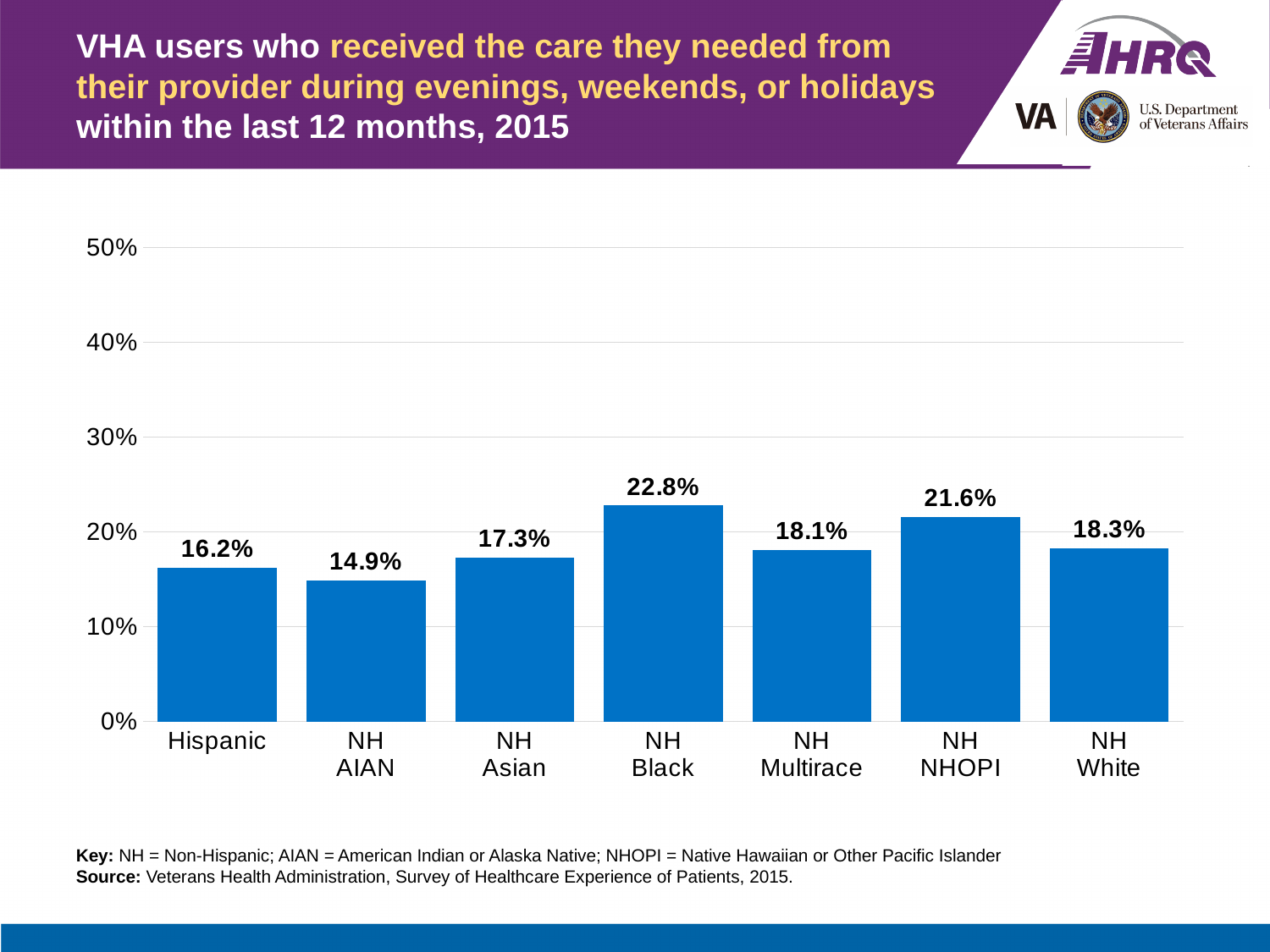
Which category has the highest value? NH Black What is the value for NH NHOPI? 21.6% What is the value for Hispanic? 16.2% What is the value for NH Black? 22.8% Which is larger, the value for NH Multirace or the value for Hispanic? NH Multirace What is the highest value labelled on the y axis? 50% How many categories are shown on the x axis? 7 Is the value for NH NHOPI greater or less than 20%? greater What is the difference between the values for NH Black and NH AIAN? 7.9% What kind of chart is shown on the slide? bar chart Which category has the lowest value? NH AIAN What is the difference between the values for NH White and NH Asian? 1.0%